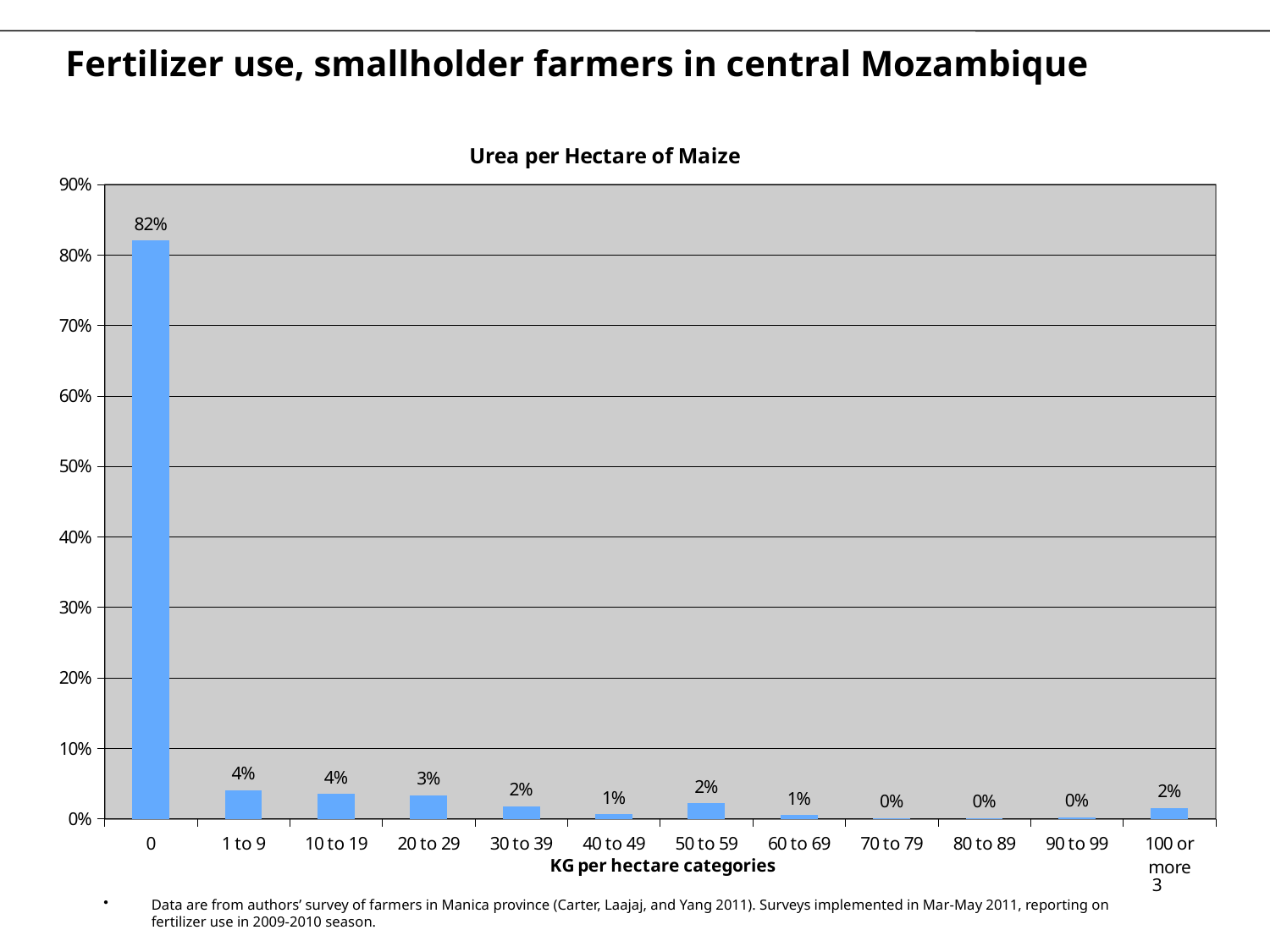
What is the difference between the values for 1 to 9 and 30 to 39? 2% What is the title of the chart? Urea per Hectare of Maize What kind of chart is shown? bar chart How many categories are shown on the x axis? 12 What is the value for the 20 to 29 category? 3% What is the x-axis label of the chart? KG per hectare categories What is the value for the 100 or more category? 2% Which is larger, the value for 10 to 19 or the value for 40 to 49? 10 to 19 Is the value for 0 greater or less than 80%? greater What is the difference between the values for 0 and 1 to 9? 78% Which category has the highest value? 0 What is the value for the 0 category? 82%